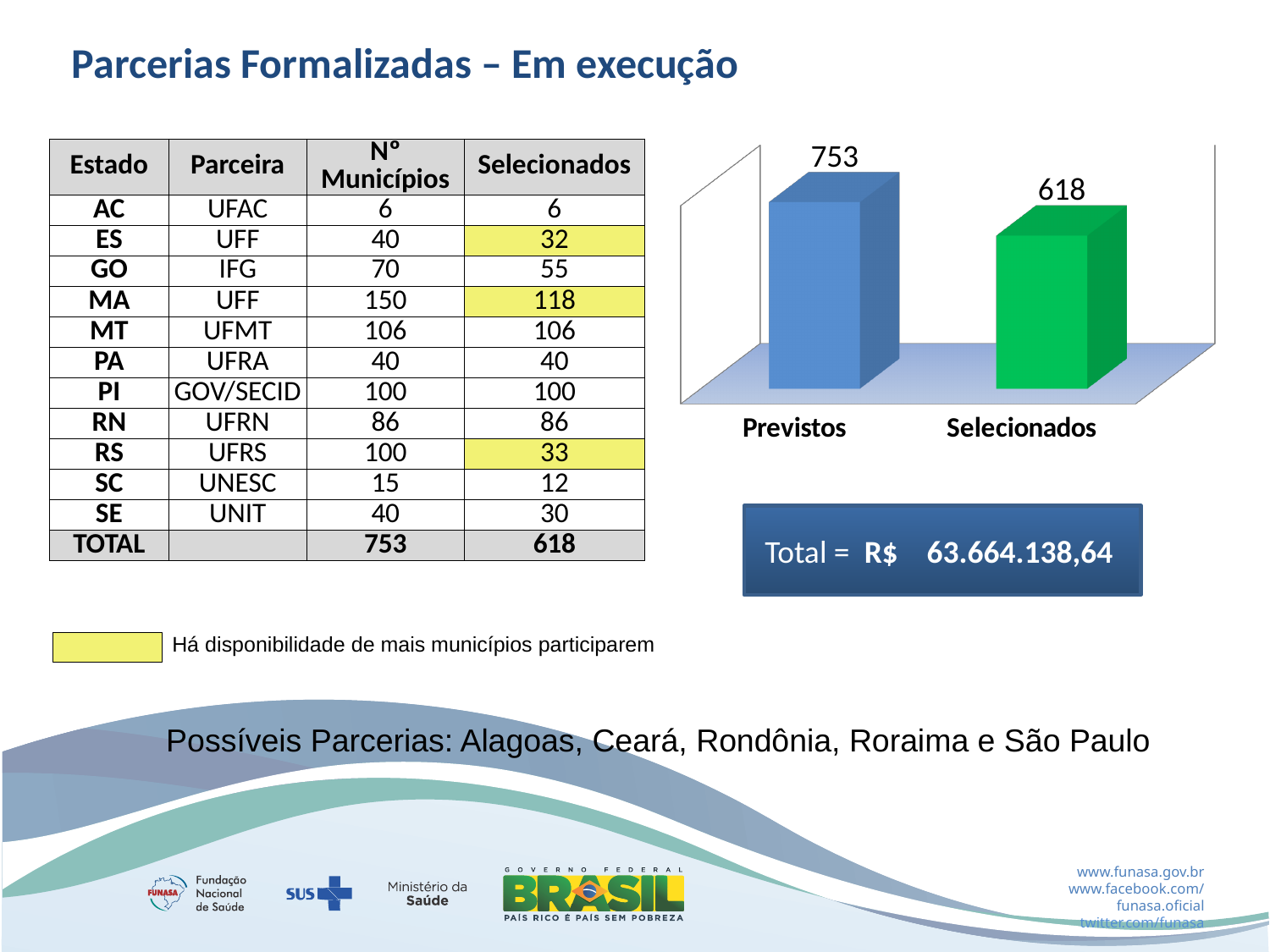
How many bars does the chart show? 2 What type of chart is shown on the slide? bar chart What colour is the Previstos bar in the chart? blue What colour is the Selecionados bar in the chart? green What is the value of the Previstos bar in the chart? 753 Which is larger in the chart, Previstos or Selecionados? Previstos Which bar in the chart is the lowest? Selecionados What is the value of the Selecionados bar in the chart? 618 What is the difference between the Previstos and Selecionados bars in the chart? 135 Do the values in the chart rise or fall from Previstos to Selecionados? fall Which bar in the chart is the highest? Previstos